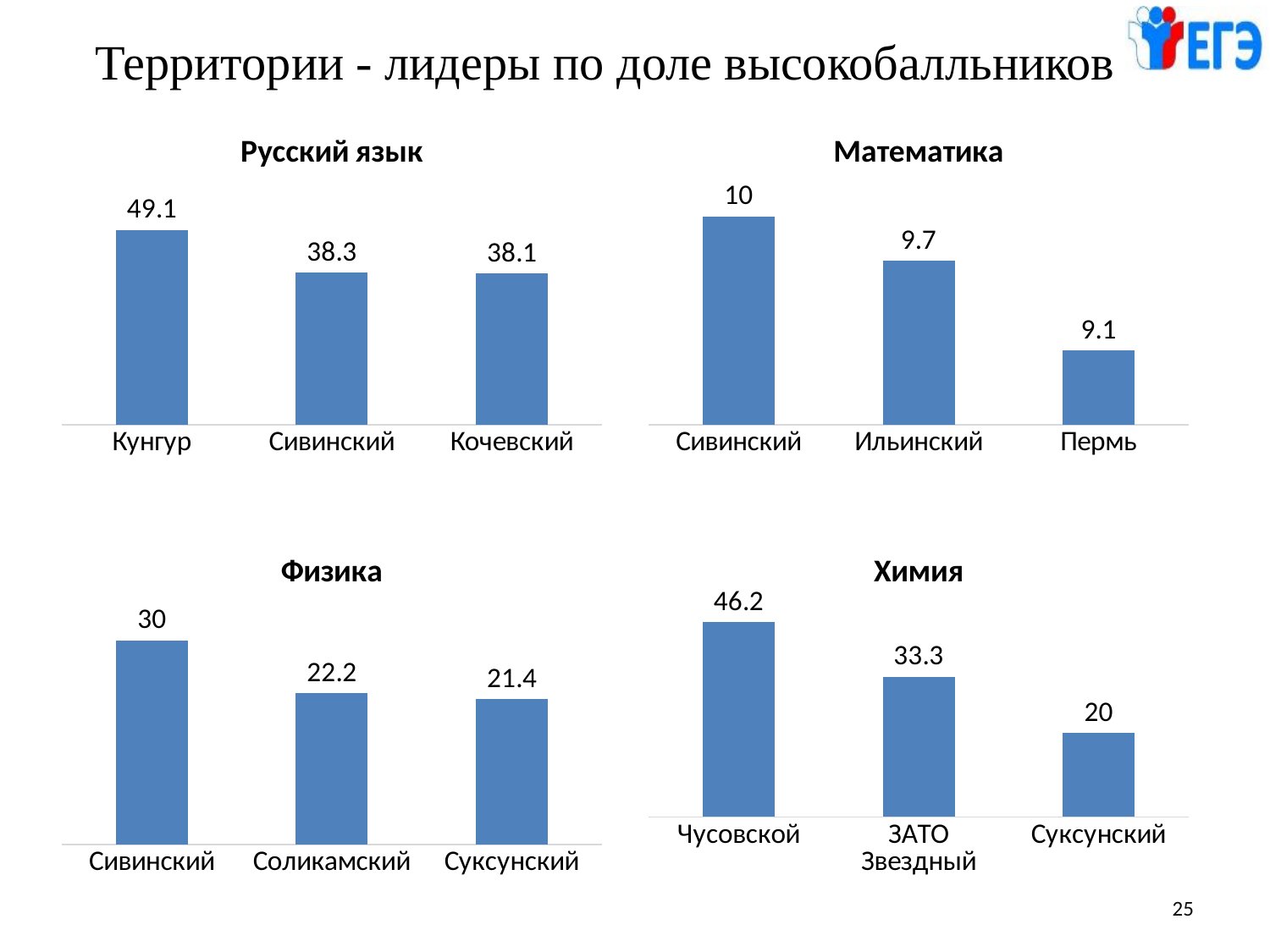
In the "Математика" chart, what is the value for Ильинский? 9.7 In the "Математика" chart, which category has the highest value? Сивинский In the "Химия" chart, what is the value for ЗАТО Звездный? 33.3 What kind of chart is the "Физика" chart? Bar chart In the "Физика" chart, which is larger, the value for Сивинский or the value for Суксунский? Сивинский In the "Русский язык" chart, what is the value for Кунгур? 49.1 In the "Русский язык" chart, which category has the lowest value? Кочевский How many categories are shown in the "Химия" chart? 3 In the "Математика" chart, what is the difference between the values for Сивинский and Пермь? 0.9 How many charts are on the slide? 4 In the "Химия" chart, what is the difference between the values for Чусовской and Суксунский? 26.2 In the "Физика" chart, what is the value for Соликамский? 22.2